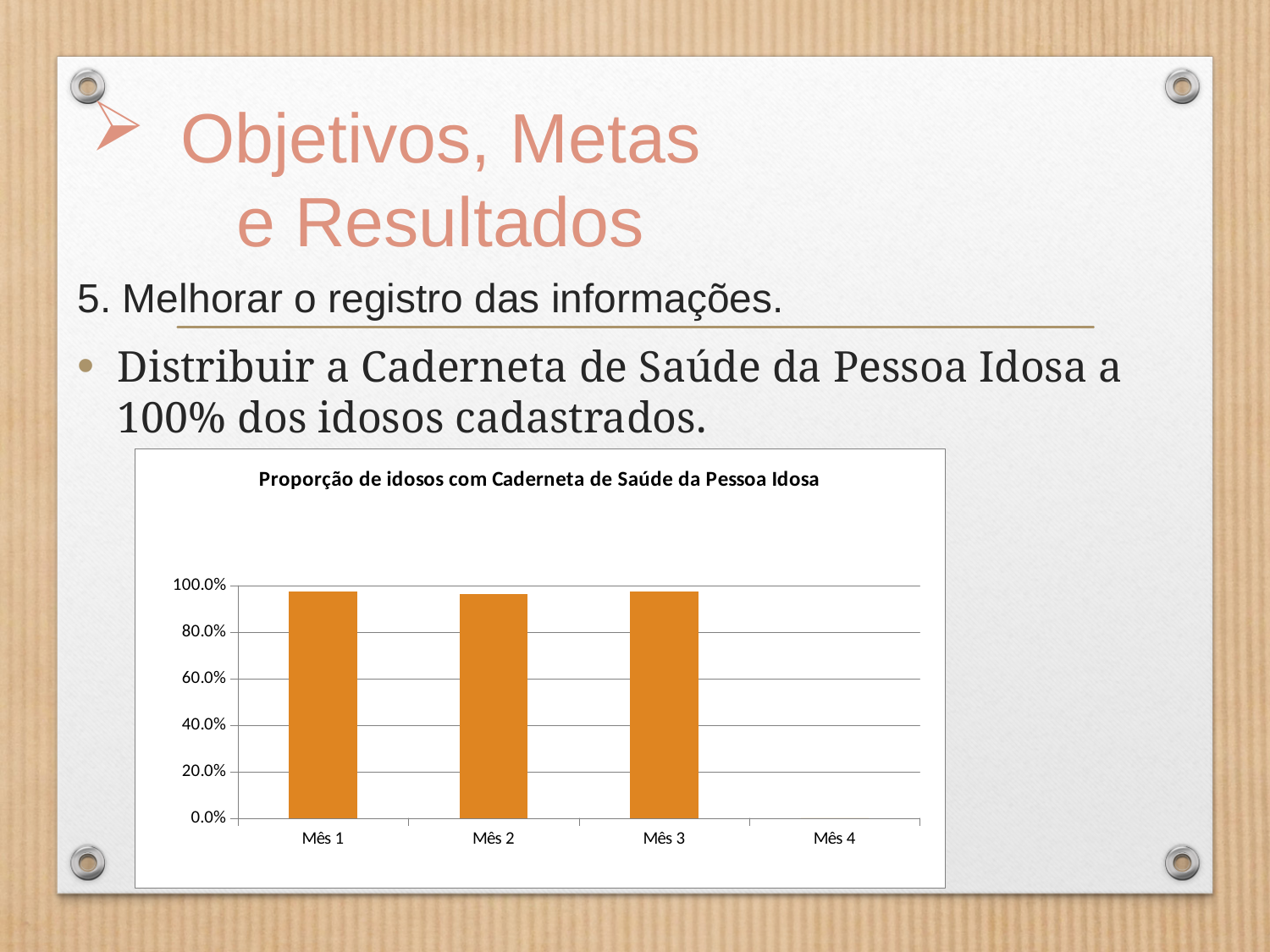
What kind of chart is shown on the slide? bar chart Is the value for Mês 4 greater or less than 20.0%? less Is the value for Mês 3 greater or less than 80.0%? greater Which is larger, the value for Mês 1 or the value for Mês 4? Mês 1 How many categories are shown on the x axis of the chart? 4 Which category has the lowest value in the chart? Mês 4 Is the value for Mês 2 greater or less than 60.0%? greater What is the title of the chart? Proporção de idosos com Caderneta de Saúde da Pessoa Idosa Which is larger, the value for Mês 3 or the value for Mês 4? Mês 3 What is the highest tick label shown on the y axis of the chart? 100.0%